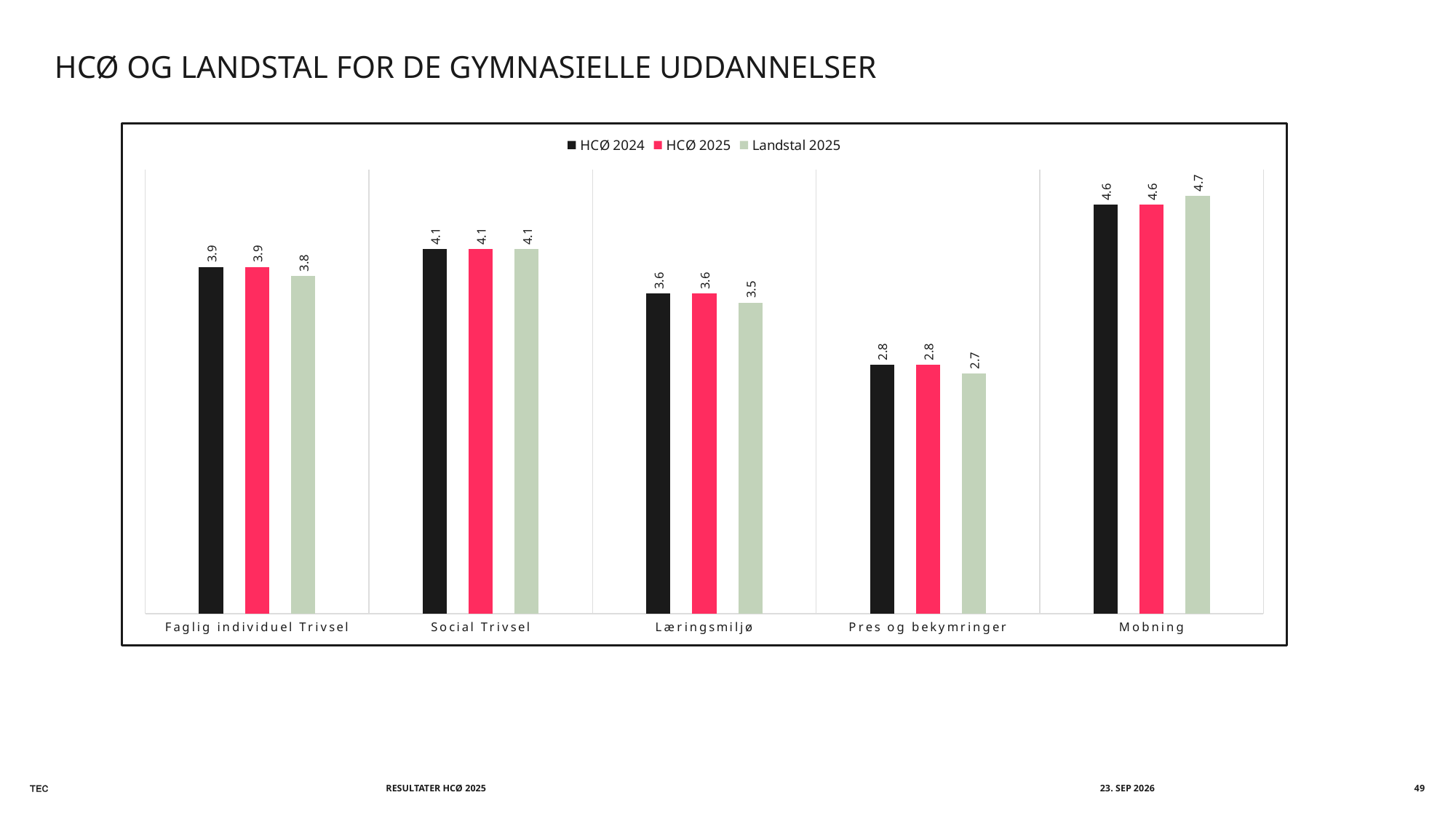
What kind of chart is shown on the slide? Bar chart Which series is shown in red in the legend? HCØ 2025 What is the HCØ 2025 value for Læringsmiljø? 3.6 What is the HCØ 2024 value for Mobning? 4.6 How many series does the legend list? 3 Which category has the highest HCØ 2025 value? Mobning What is the difference between the Landstal 2025 value and the HCØ 2025 value for Mobning? 0.1 Which is larger for Læringsmiljø: the HCØ 2024 value or the Landstal 2025 value? HCØ 2024 How many categories are shown on the x axis? 5 What is the Landstal 2025 value for Faglig individuel Trivsel? 3.8 Which category has the lowest Landstal 2025 value? Pres og bekymringer What is the Landstal 2025 value for Pres og bekymringer? 2.7